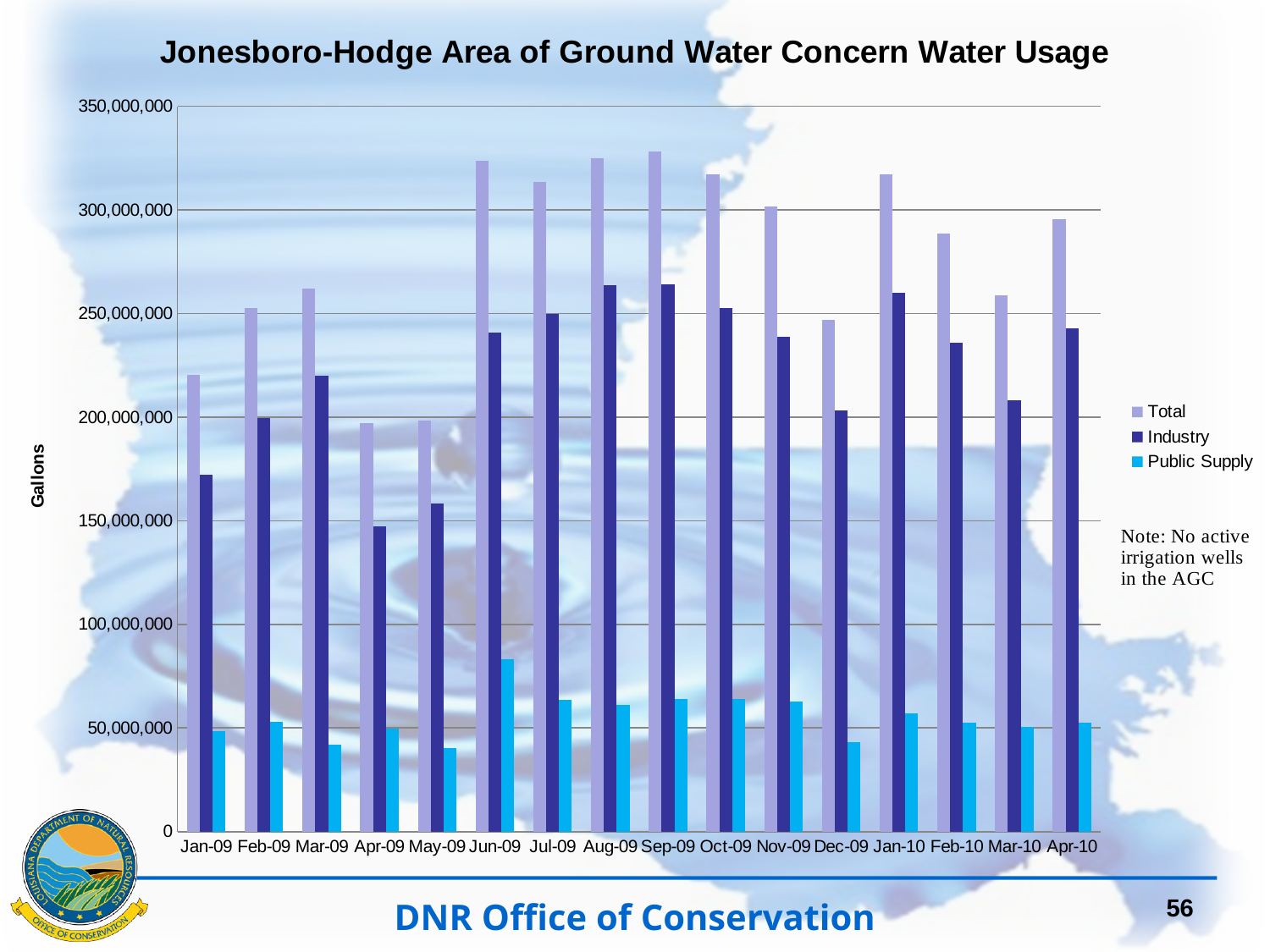
What kind of chart is shown on the slide? bar chart How many months are shown along the x axis? 16 Does the Total value rise or fall from Sep-09 to Dec-09? fall What is the label on the vertical axis? Gallons Which is larger, the Total value for Jan-09 or the Total value for Mar-09? Mar-09 How many series does the legend list? 3 Is the Total value for Feb-10 greater or less than 300,000,000? less Is the Total value for Jan-09 greater or less than 200,000,000? greater Which month has the highest Public Supply value? Jun-09 Which month has the lowest Industry value? Apr-09 Is the Industry value for Apr-09 greater or less than 150,000,000? less